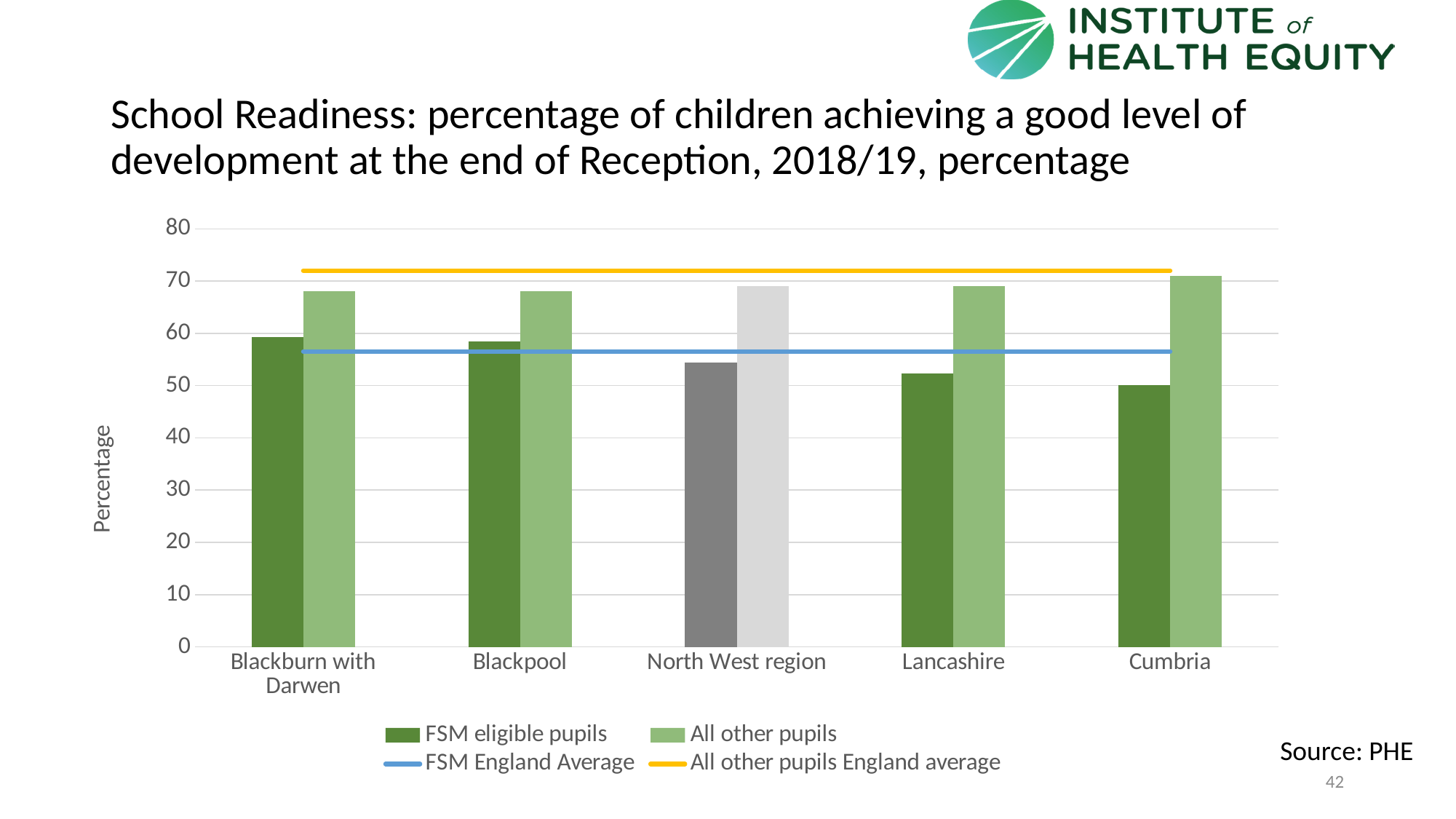
Is the value for FSM eligible pupils in Lancashire greater or less than 50? greater Which area has the highest value for All other pupils? Cumbria Which is larger: the FSM eligible pupils value for Blackburn with Darwen or for Cumbria? Blackburn with Darwen What is the label on the y axis? Percentage Is the value for FSM eligible pupils in the North West region greater or less than 50? greater What kind of chart is shown on the slide? combination bar and line chart Which area has the lowest value for FSM eligible pupils? Cumbria What colour is the line representing the FSM England Average? blue How many areas (categories) are shown on the x axis? 5 Is the value for All other pupils in Blackburn with Darwen greater or less than 70? less How many series does the legend list? 4